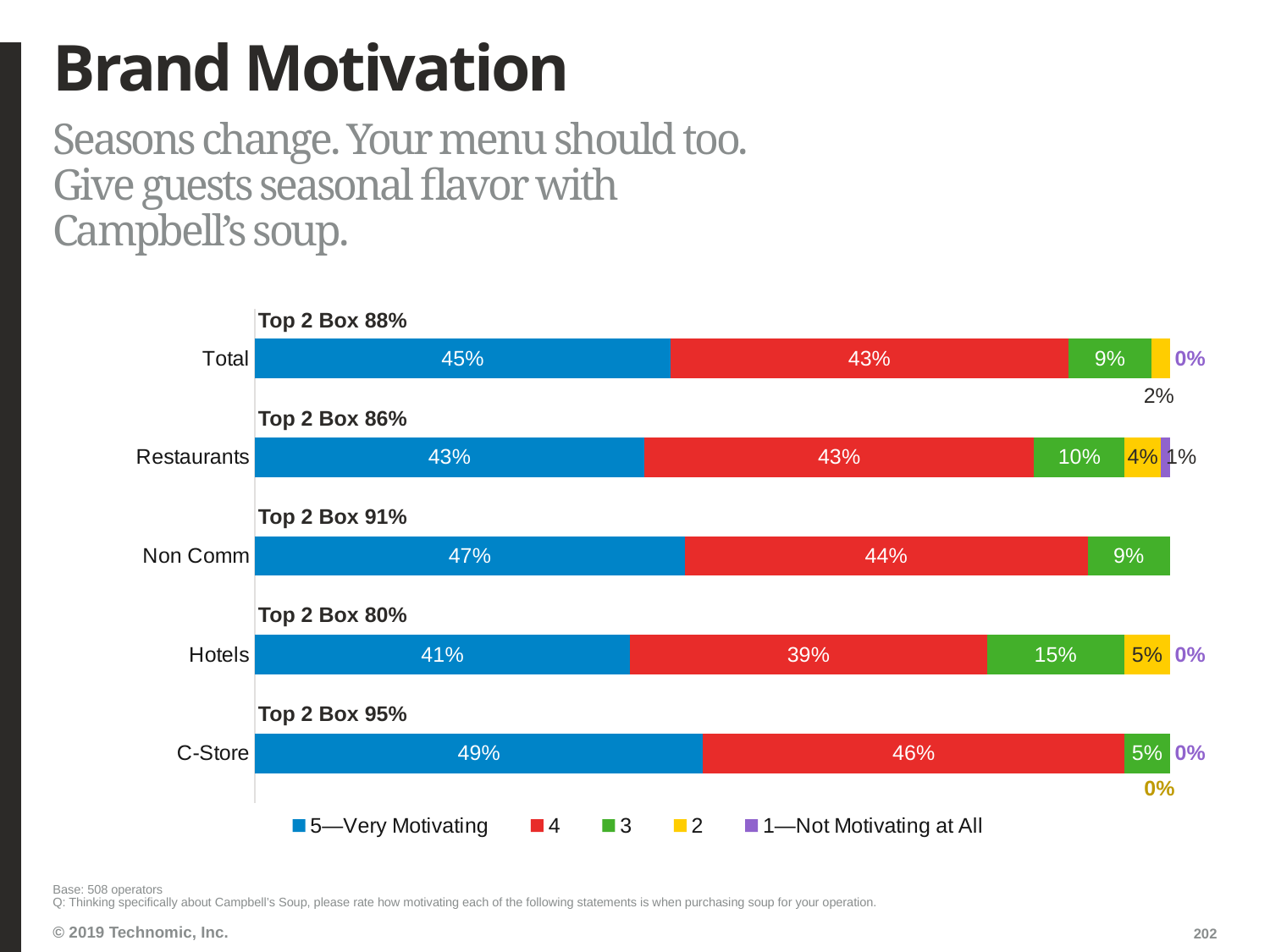
What is the legend label for the purple series? 1—Not Motivating at All What percentage of Total respondents rated the statement 5—Very Motivating? 45% Which is larger: the share rating 3 for Hotels or the share rating 3 for Total? Hotels How many series does the legend list? 5 Which segment has the lowest Top 2 Box score? Hotels What is the Top 2 Box score shown for Non Comm? 91% Which segment has the highest share rating the statement 5—Very Motivating? C-Store What is the difference in percentage points between the 5—Very Motivating share for C-Store and for Hotels? 8 percentage points What type of chart is shown on the slide? Stacked bar chart How many segments (bars) are shown in the chart? 5 What percentage of Hotels respondents gave a rating of 3? 15% What percentage of Restaurants respondents gave a rating of 2? 4%